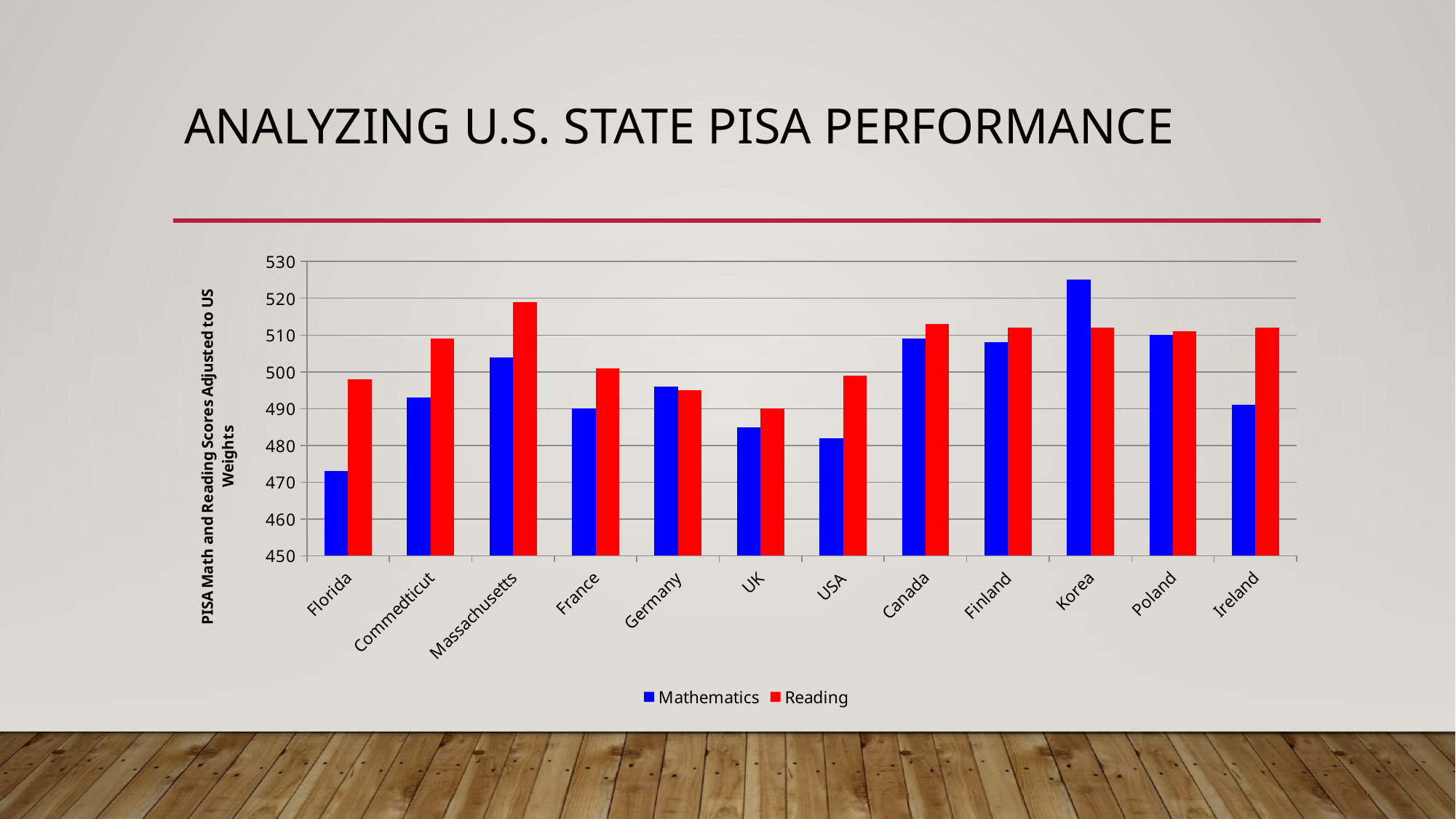
Which category has the lowest Mathematics value? Florida What kind of chart is shown on the slide? bar chart Which category has the highest Reading value? Massachusetts Is the Mathematics value for Florida greater or less than 480? less What is the label of the vertical axis? PISA Math and Reading Scores Adjusted to US Weights Which category has the lowest Reading value? UK How many series does the legend list? 2 How many categories are shown on the x axis? 12 Is the Mathematics value for Korea greater or less than 520? greater For Korea, which is larger, the Mathematics value or the Reading value? Mathematics Which category has the highest Mathematics value? Korea For Florida, which is larger, the Mathematics value or the Reading value? Reading